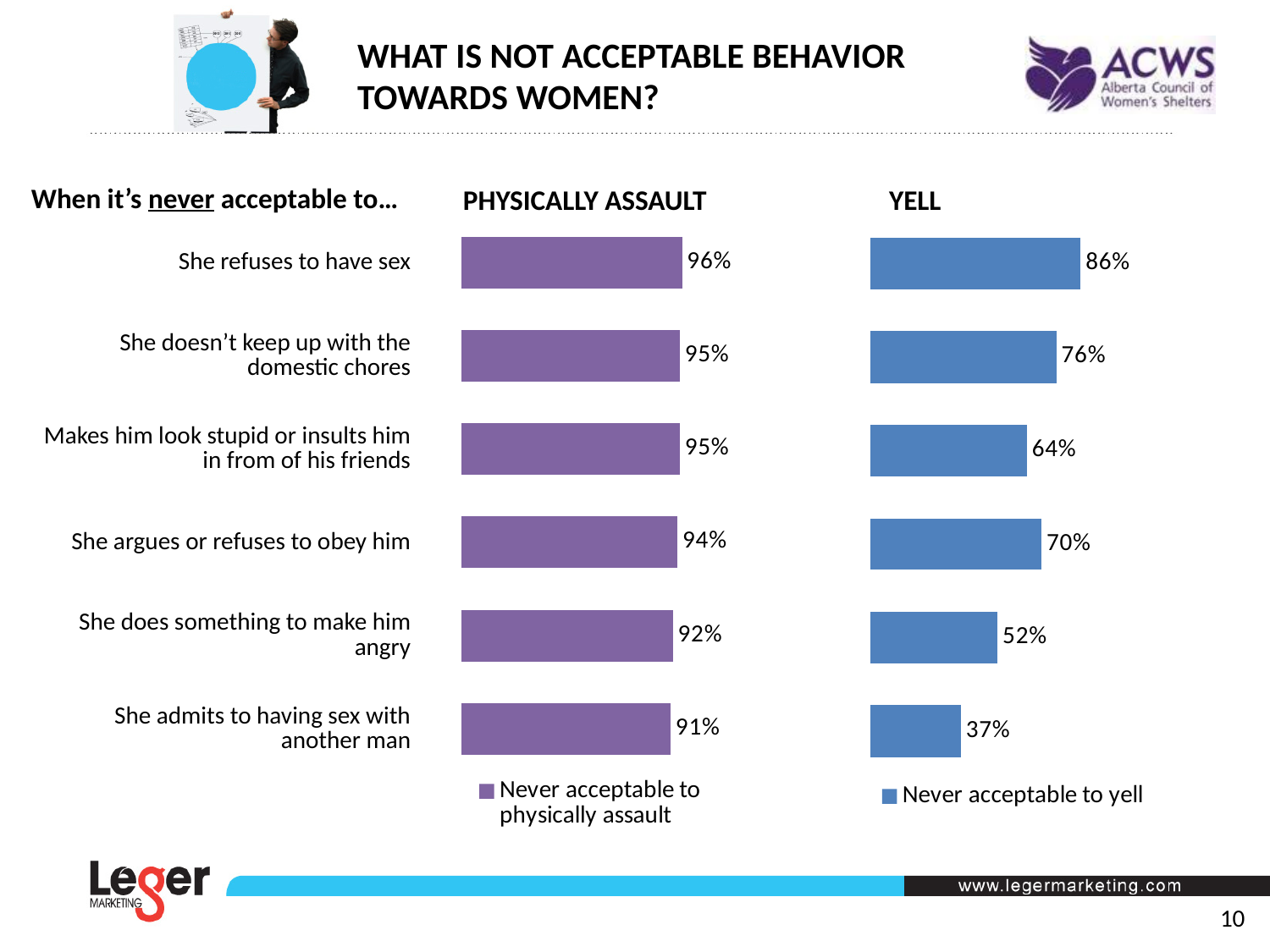
In the YELL chart, what percentage say it is never acceptable when she admits to having sex with another man? 37% In the YELL chart, which category has the highest value? She refuses to have sex In the PHYSICALLY ASSAULT chart, which category has the lowest value? She admits to having sex with another man In the YELL chart, which category has the lowest value? She admits to having sex with another man What type of chart is the YELL chart? Bar chart In the PHYSICALLY ASSAULT chart, what percentage say it is never acceptable when she refuses to have sex? 96% What is the legend entry for the PHYSICALLY ASSAULT chart? Never acceptable to physically assault What is the difference between the PHYSICALLY ASSAULT and YELL values for 'She does something to make him angry'? 40 percentage points In the YELL chart, what is the value for 'She argues or refuses to obey him'? 70% How many categories are shown in the PHYSICALLY ASSAULT chart? 6 In the YELL chart, which is larger: 'She argues or refuses to obey him' or 'Makes him look stupid or insults him in from of his friends'? She argues or refuses to obey him In the YELL chart, what is the difference between 'She refuses to have sex' and 'She doesn't keep up with the domestic chores'? 10 percentage points